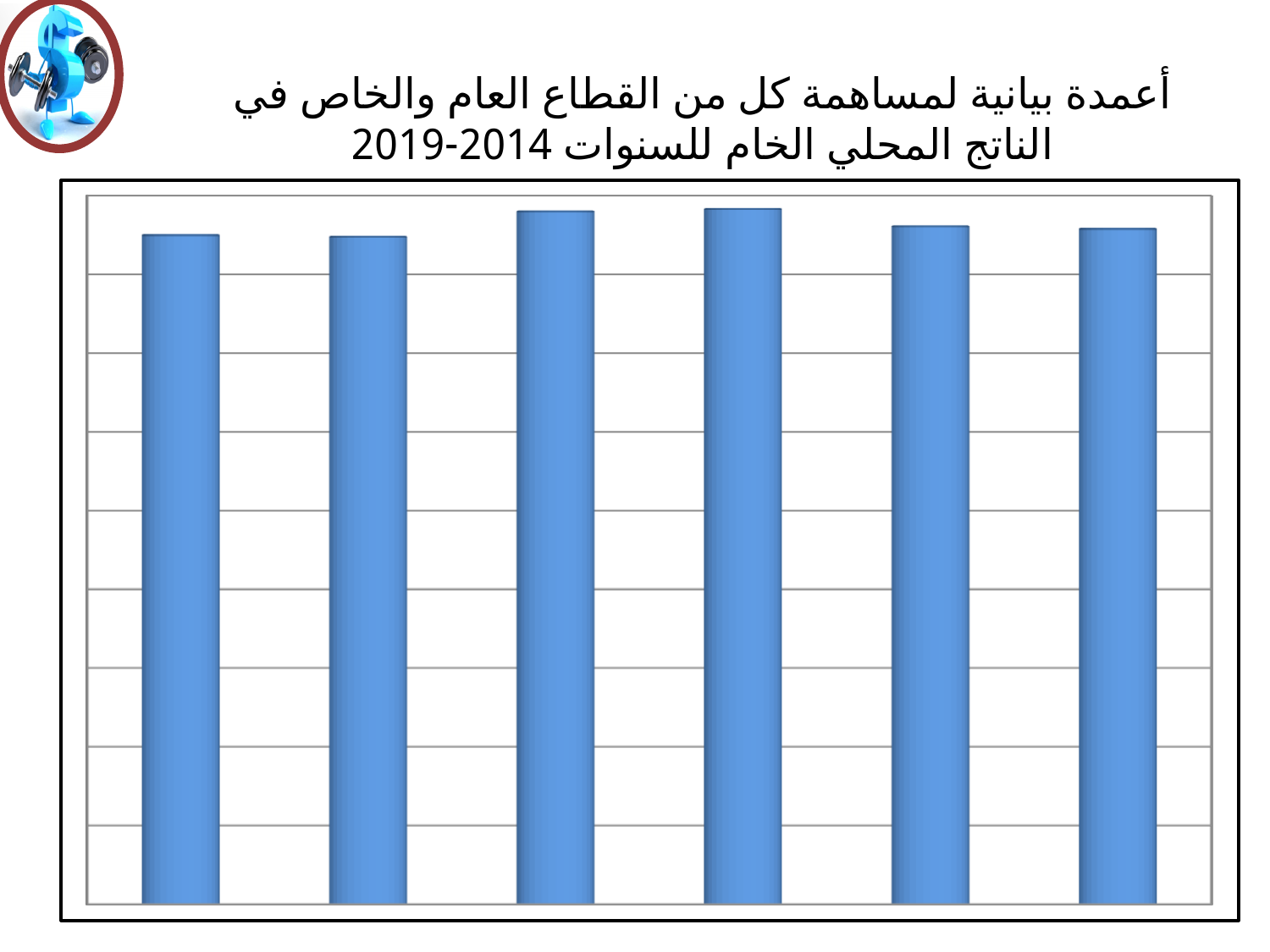
Which range of years does the chart title say the data covers? 2014-2019 What kind of chart is shown on the slide? bar chart What colour are the bars in the chart? blue How many bars are plotted in the chart? 6 Is the second bar from the left taller or shorter than the third bar from the left? shorter Is the fourth bar from the left taller or shorter than the first bar from the left? taller